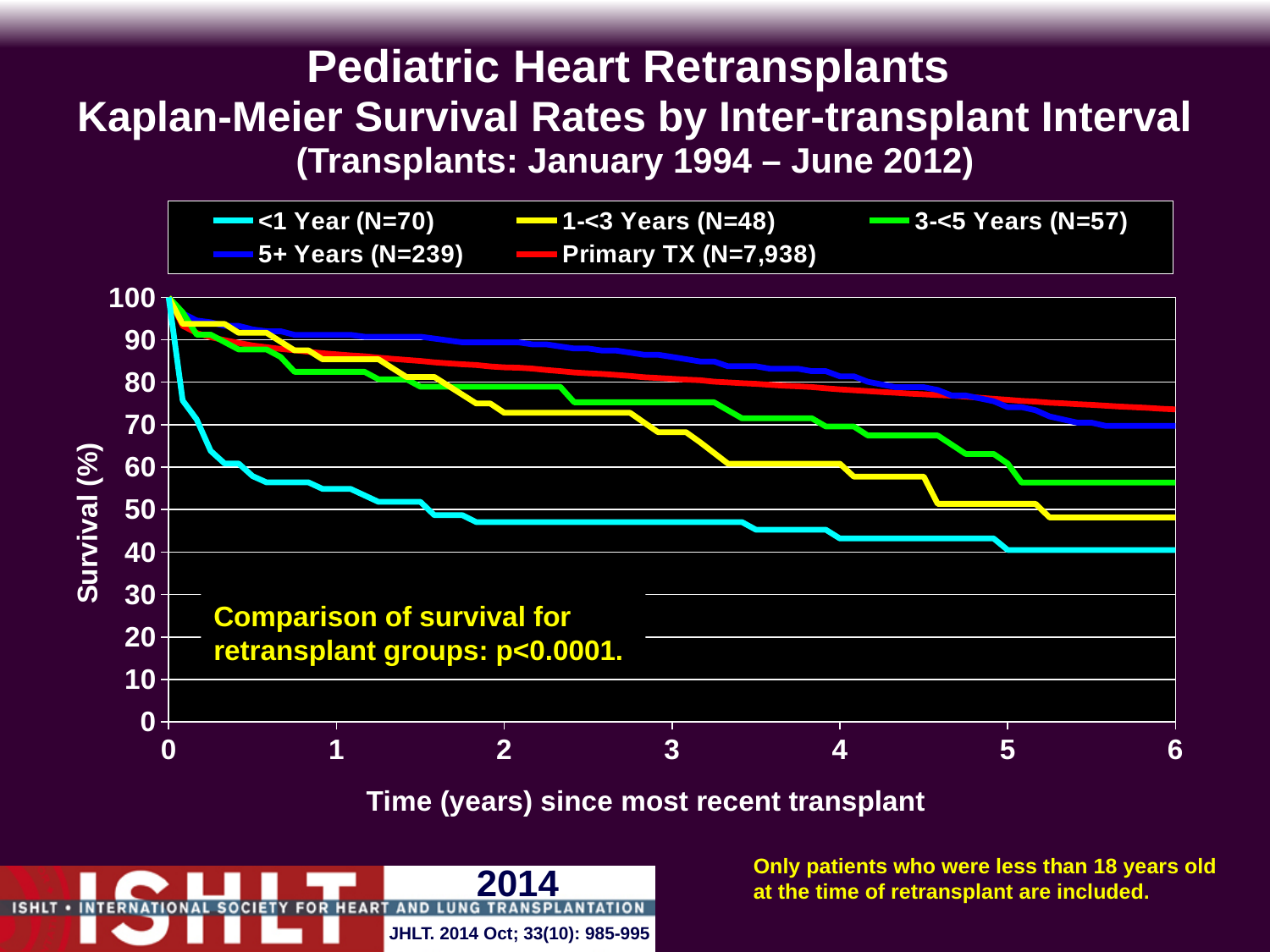
Is the survival for the 1-<3 Years group at 6 years greater or less than 50? less What is the survival value for all groups at time 0? 100 What kind of chart is shown on the slide? line chart Which series has the lowest survival at 6 years since most recent transplant? <1 Year (N=70) Is the survival for the <1 Year group at 3 years greater or less than 50? less Do the survival curves rise or fall as time since most recent transplant increases? fall Is the survival for the 3-<5 Years group at 6 years greater or less than 50? greater At 6 years, which has higher survival: the Primary TX group or the <1 Year group? Primary TX How many series does the legend list? 5 What is the N for the 5+ Years group shown in the legend? 239 What is the label of the x axis? Time (years) since most recent transplant